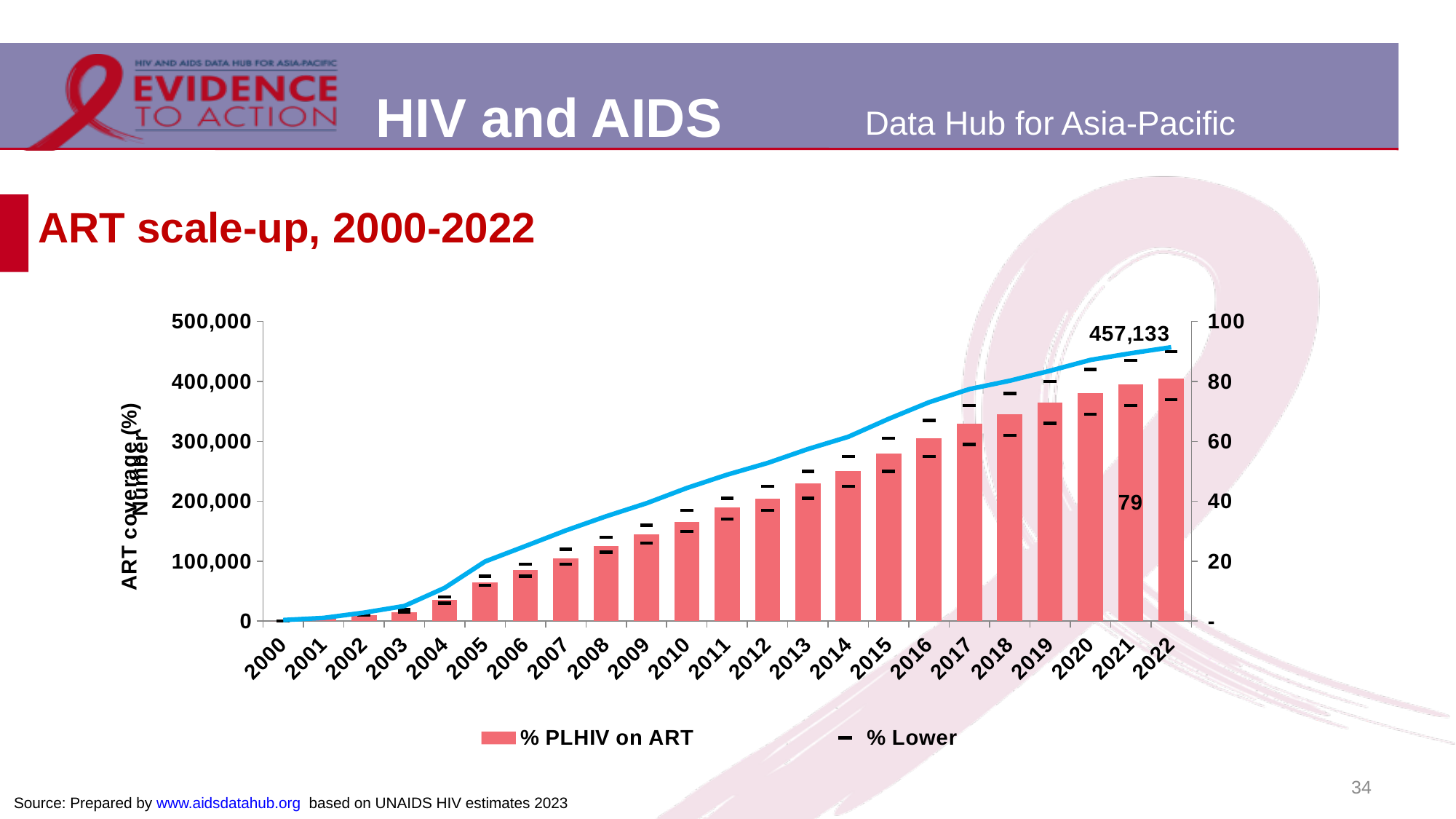
What is the title of the chart? ART scale-up, 2000-2022 Which year has the lowest bar? 2000 Which year has the highest bar? 2022 How many years are shown along the x axis? 23 What is the data label shown on the line at 2022? 457,133 Do the bar values rise or fall from 2000 to 2022? Rise What kind of chart is this? Combined bar and line chart How many entries does the legend list? 2 Is the bar value for 2010 on the right axis greater or less than 40? less Is the line value for 2020 on the left axis greater or less than 400,000? greater Which year has the larger bar, 2015 or 2022? 2022